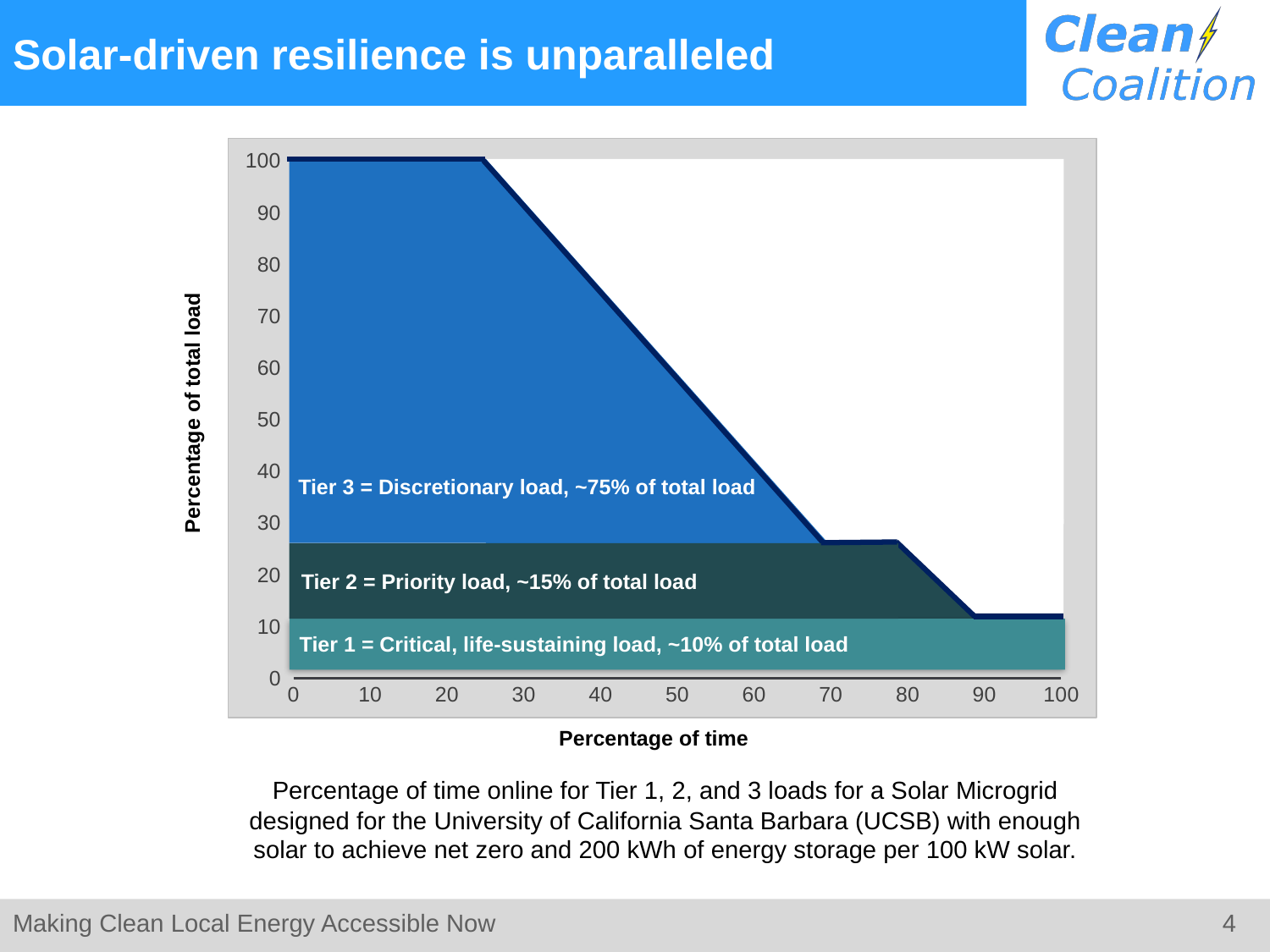
Is the percentage of total load at 90% of time greater or less than 20? less What is the title of the y axis? Percentage of total load What is the title of the x axis? Percentage of time What is the highest percentage of total load reached by the line? 100 What kind of chart is shown on the slide? Area chart Is the percentage of total load at 50% of time greater or less than 50? greater Does the percentage of total load rise or fall as the percentage of time increases? Fall How many load tiers are labelled on the chart? 3 Is the percentage of total load at 100% of time greater or less than 20? less What is the percentage of total load at 10% of time? 100